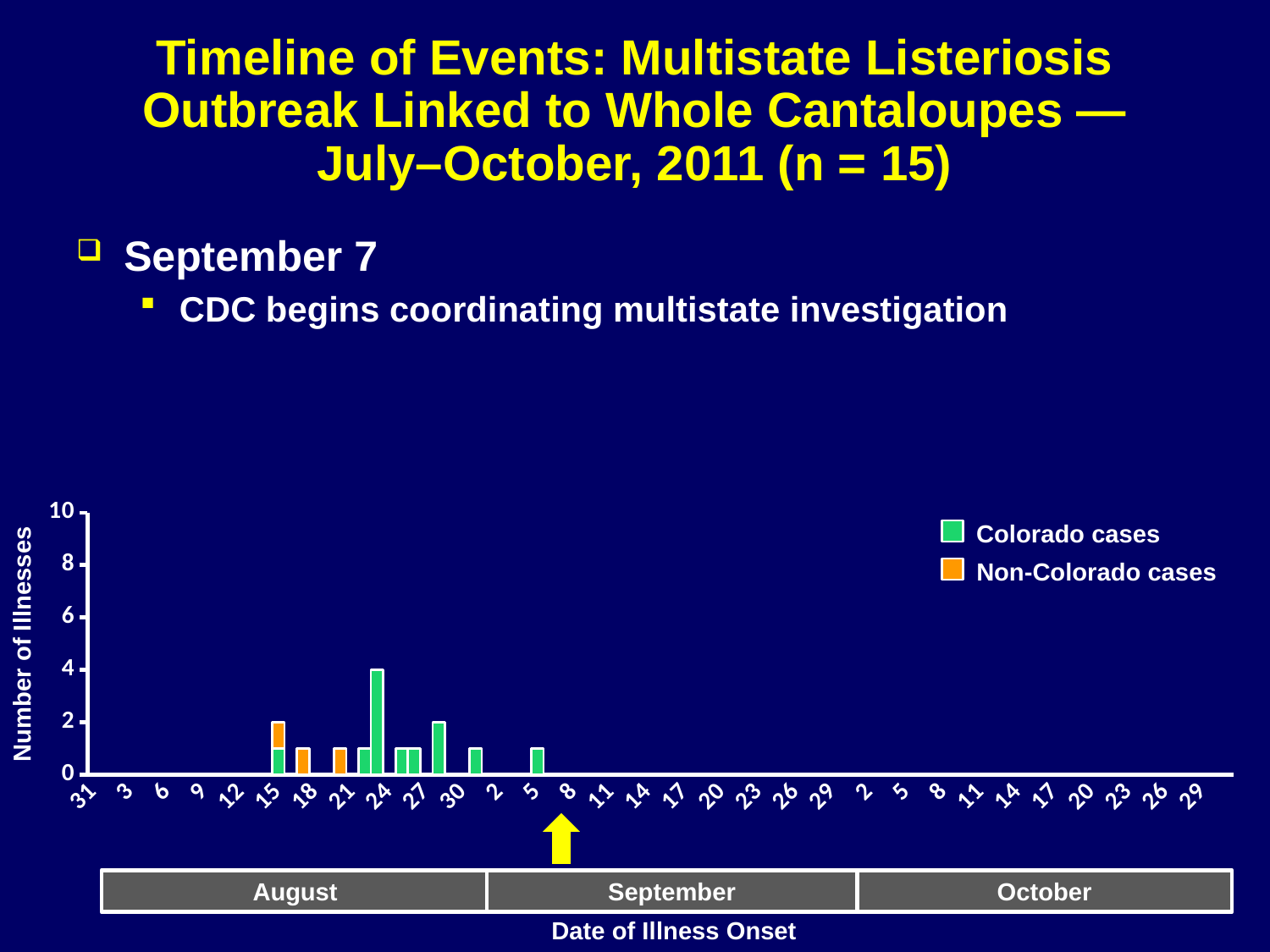
Which month has the most illnesses on the chart? August Is the value of the tallest bar greater or less than 6? less Is the value of the tallest bar greater or less than 2? greater Do the number of illnesses rise or fall from late August into September? fall What are the two series named in the legend? Colorado cases and Non-Colorado cases How many bars appear in the October section of the chart? 0 Which series does the tallest bar belong to? Colorado cases How many series does the legend list? 2 Which series has more bars on the chart, Colorado cases or Non-Colorado cases? Colorado cases What is the number of illnesses for the tallest bar on the chart? 4 What is the label on the vertical axis? Number of Illnesses What kind of chart is shown on the slide? bar chart